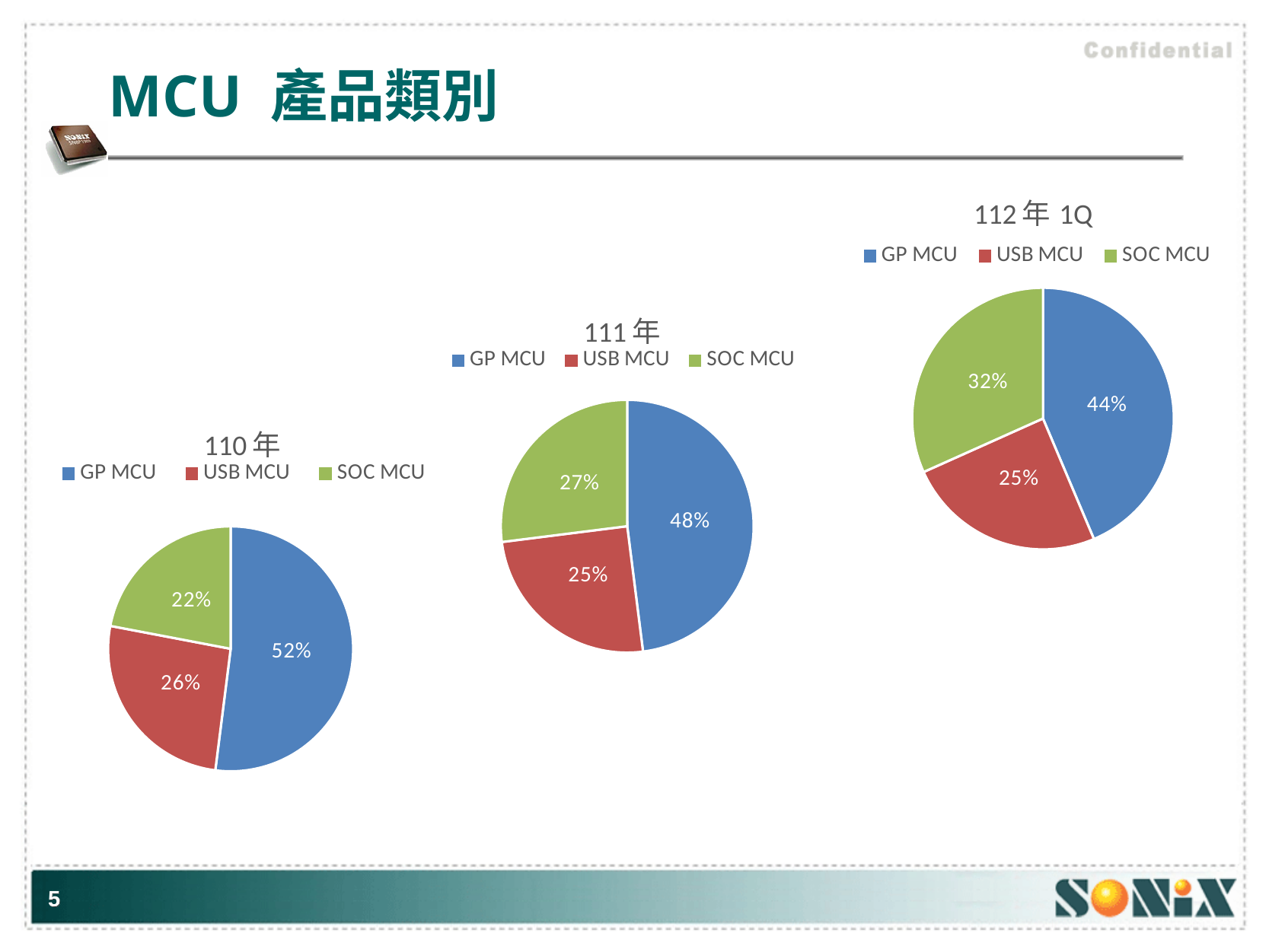
In the "111 年" pie chart, what share does SOC MCU have? 27% In the "110 年" pie chart, which category has the smallest share? SOC MCU What kind of chart is the "112 年 1Q" chart? Pie chart In the "110 年" pie chart, what share does GP MCU have? 52% In the "112 年 1Q" pie chart, which category has the largest share? GP MCU In the "112 年 1Q" pie chart, which is larger, the SOC MCU share or the USB MCU share? SOC MCU How many pie charts are shown on the slide? 3 In the "111 年" pie chart, what is the difference between the GP MCU share and the USB MCU share? 23% How many slices does the "110 年" pie chart have? 3 How many entries does the legend of the "111 年" chart list? 3 In the "112 年 1Q" pie chart, what share does USB MCU have? 25% In the "110 年" pie chart, what colour is the USB MCU slice? Red